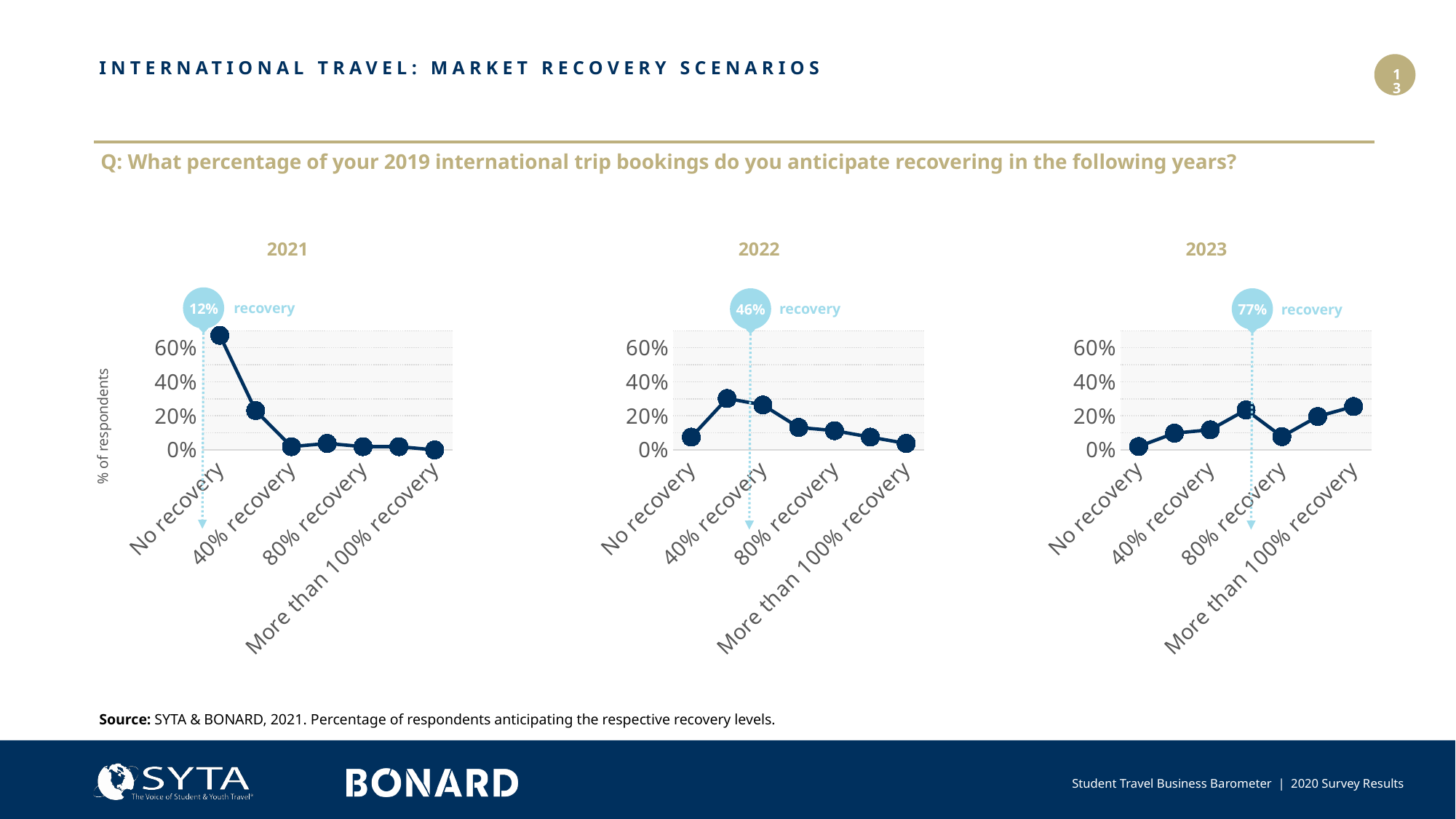
On the 2021 chart, is the value for No recovery greater or less than 60%? greater On the 2023 chart, which category has the lowest value? No recovery On the 2023 chart, is the value for More than 100% recovery greater or less than 20%? greater On the 2022 chart, is the value for 40% recovery greater or less than 20%? greater On the 2023 chart, which is larger: the value for No recovery or the value for More than 100% recovery? More than 100% recovery How many data points are plotted on the 2022 chart? 7 On the 2021 chart, which category has the highest value? No recovery On the 2021 chart, do the values generally rise or fall from left to right along the x axis? fall What kind of chart is used for the 2021 panel? line chart What recovery percentage is highlighted in the callout above the 2023 chart? 77% On the 2021 chart, which is larger: the value for No recovery or the value for 40% recovery? No recovery